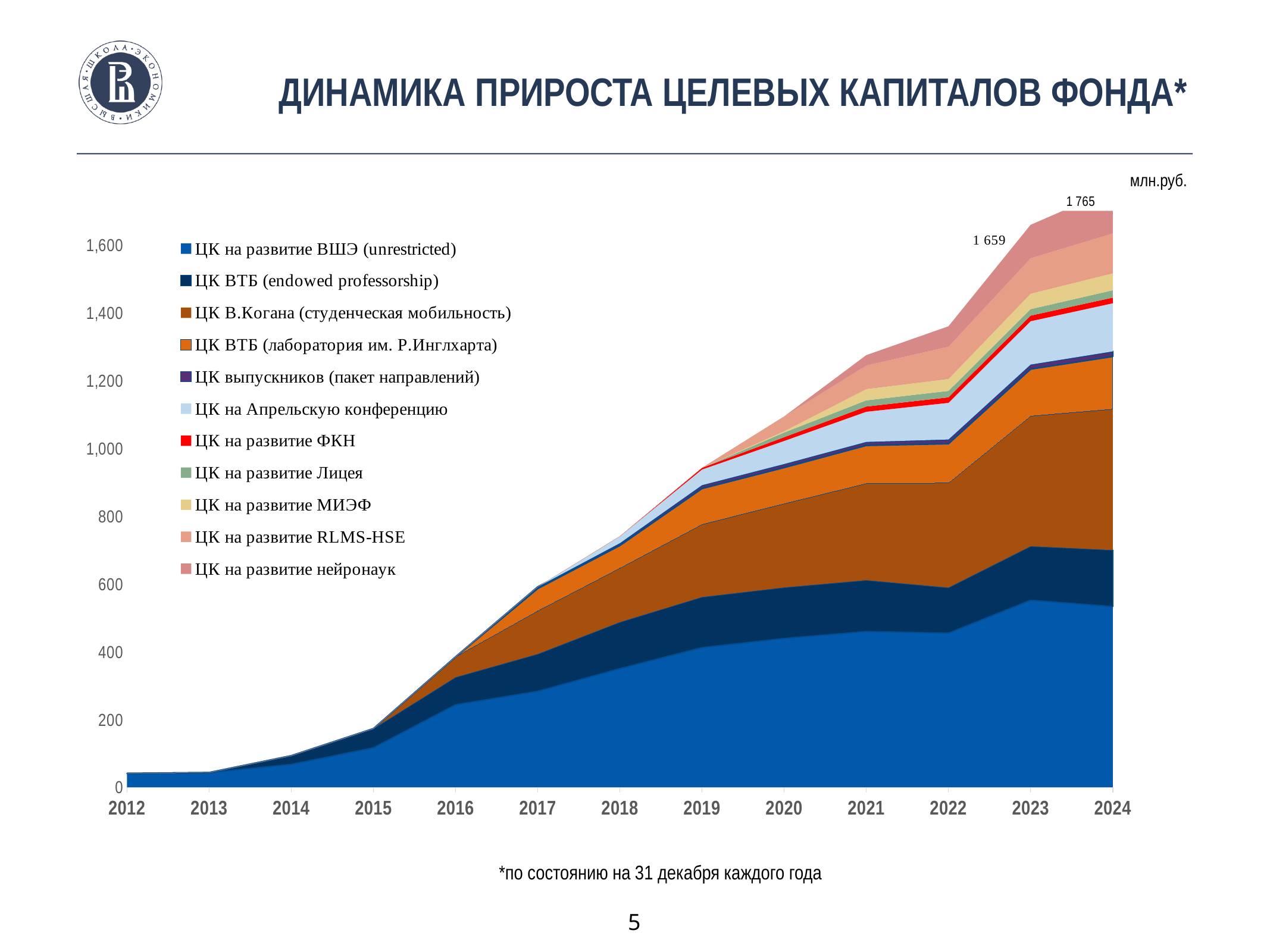
By how much did the labelled total grow from 2023 to 2024? 106 Which year has the larger total, 2023 or 2024? 2024 How many years are plotted along the x axis of the chart? 13 Is the total value for 2015 greater or less than 200? less Do the total values rise or fall from 2012 to 2024? rise How many series does the chart's legend list? 11 What is the total value of the endowment capitals shown for 2023? 1 659 What unit of measurement is indicated in the top right corner of the chart? млн.руб. Which year has the highest total value in the chart? 2024 What is the total value of the endowment capitals shown for 2024? 1 765 Is the total value for 2019 greater or less than 800? greater What kind of chart is shown on the slide? stacked area chart